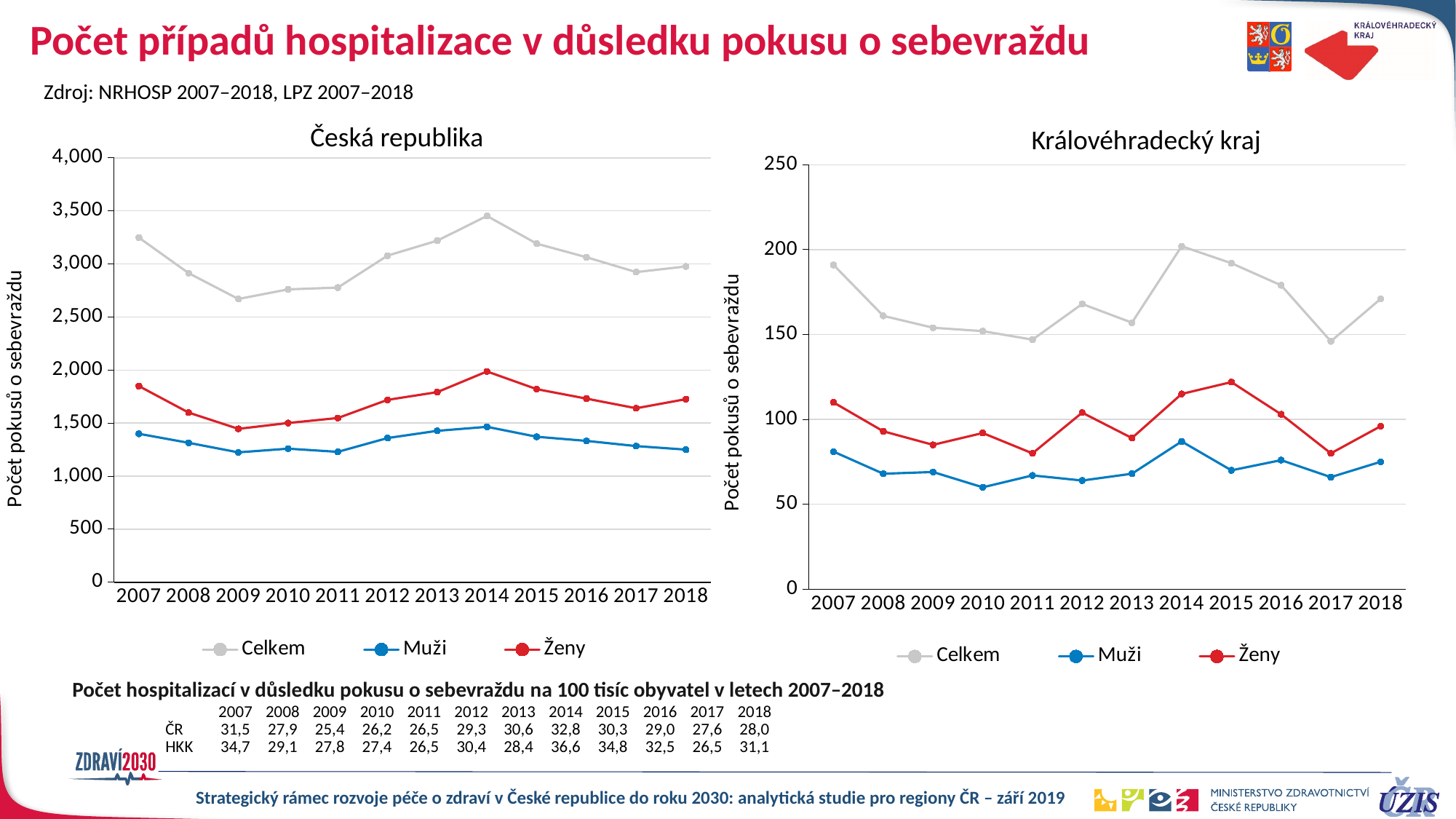
In the Česká republika chart, in which year does the Celkem series reach its highest value? 2014 How many series does the legend of the Královéhradecký kraj chart list? 3 In the Královéhradecký kraj chart, in which year does the Celkem series reach its highest value? 2014 In the Královéhradecký kraj chart, is the Celkem value for 2007 greater or less than 150? greater In the Česká republika chart, is the Celkem value for 2014 greater or less than 3,000? greater What type of chart is the Česká republika chart? Line chart In the Česká republika chart, in which year is the Celkem series at its lowest? 2009 In the Královéhradecký kraj chart, in which year is the Muži series at its lowest? 2010 In the Královéhradecký kraj chart, is the Ženy value for 2015 greater or less than 100? greater How many years are shown on the x axis of the Česká republika chart? 12 In the Česká republika chart, which series is higher in 2014, Muži or Ženy? Ženy